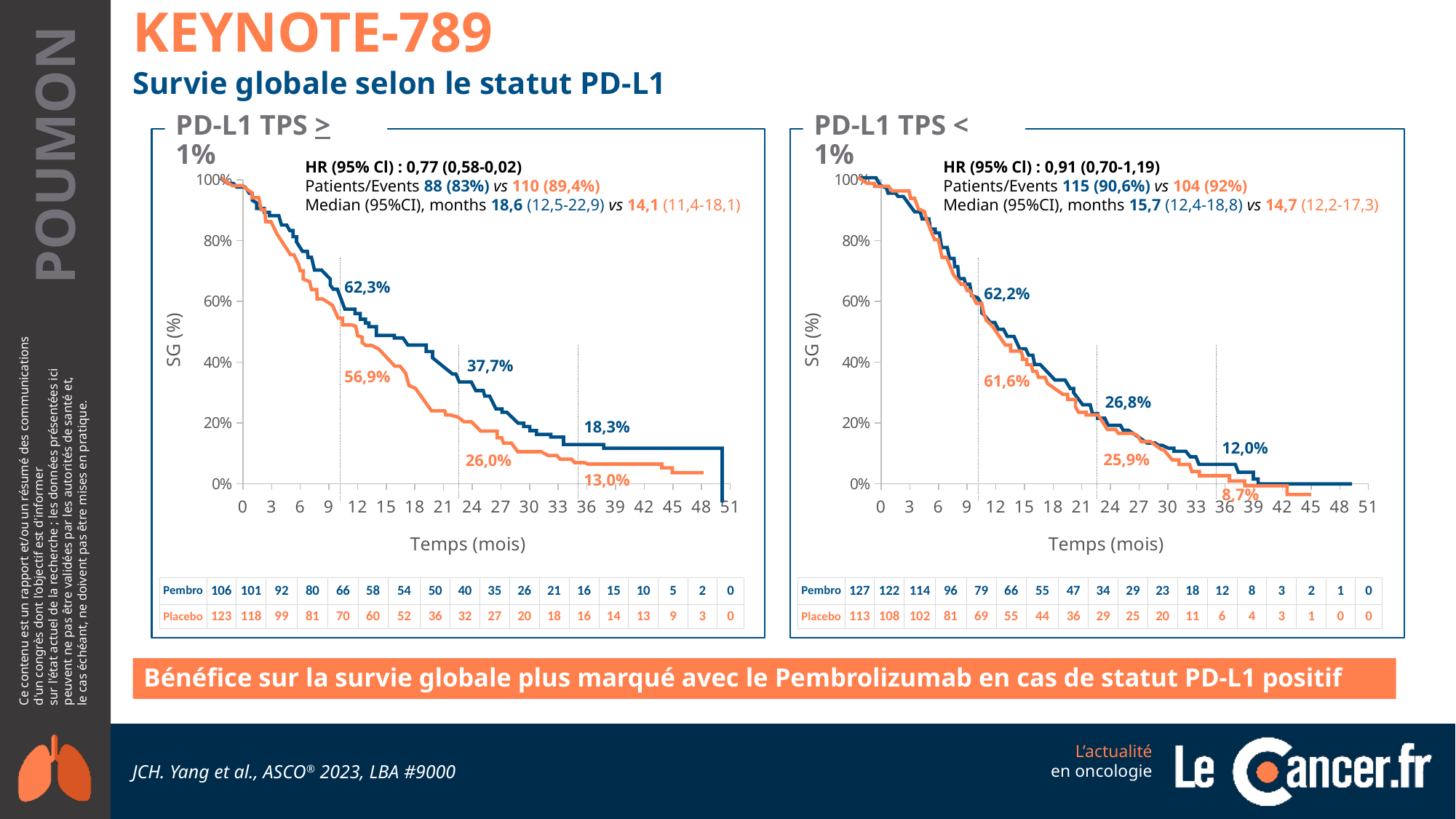
In the PD-L1 TPS ≥ 1% chart, what is the difference between the first labelled Pembro value (62,3%) and the first labelled Placebo value (56,9%)? 5,4 percentage points In the PD-L1 TPS ≥ 1% chart, how many Pembro patients are at risk at time 0 according to the table below the chart? 106 In the PD-L1 TPS < 1% chart, what is the median overall survival in months for Pembro? 15,7 In the PD-L1 TPS < 1% chart, which is larger at the second landmark: the Pembro value (26,8%) or the Placebo value (25,9%)? Pembro (26,8%) In the PD-L1 TPS ≥ 1% chart, what is the last labelled survival value for the Placebo (orange) curve? 13,0% What kind of chart is used in the PD-L1 TPS ≥ 1% panel? line chart In the PD-L1 TPS < 1% chart, what is the last labelled survival value for the Placebo curve? 8,7% In the PD-L1 TPS ≥ 1% chart, what is the first labelled survival value for the Pembro (blue) curve? 62,3% In the PD-L1 TPS ≥ 1% chart, is the Pembro curve at 12 months greater or less than 40%? greater How many treatment arms (series) are plotted in each survival chart? 2 In the PD-L1 TPS ≥ 1% chart, do the survival curves rise or fall as time increases along the x axis? fall What is the hazard ratio (HR) reported in the PD-L1 TPS ≥ 1% chart? 0,77